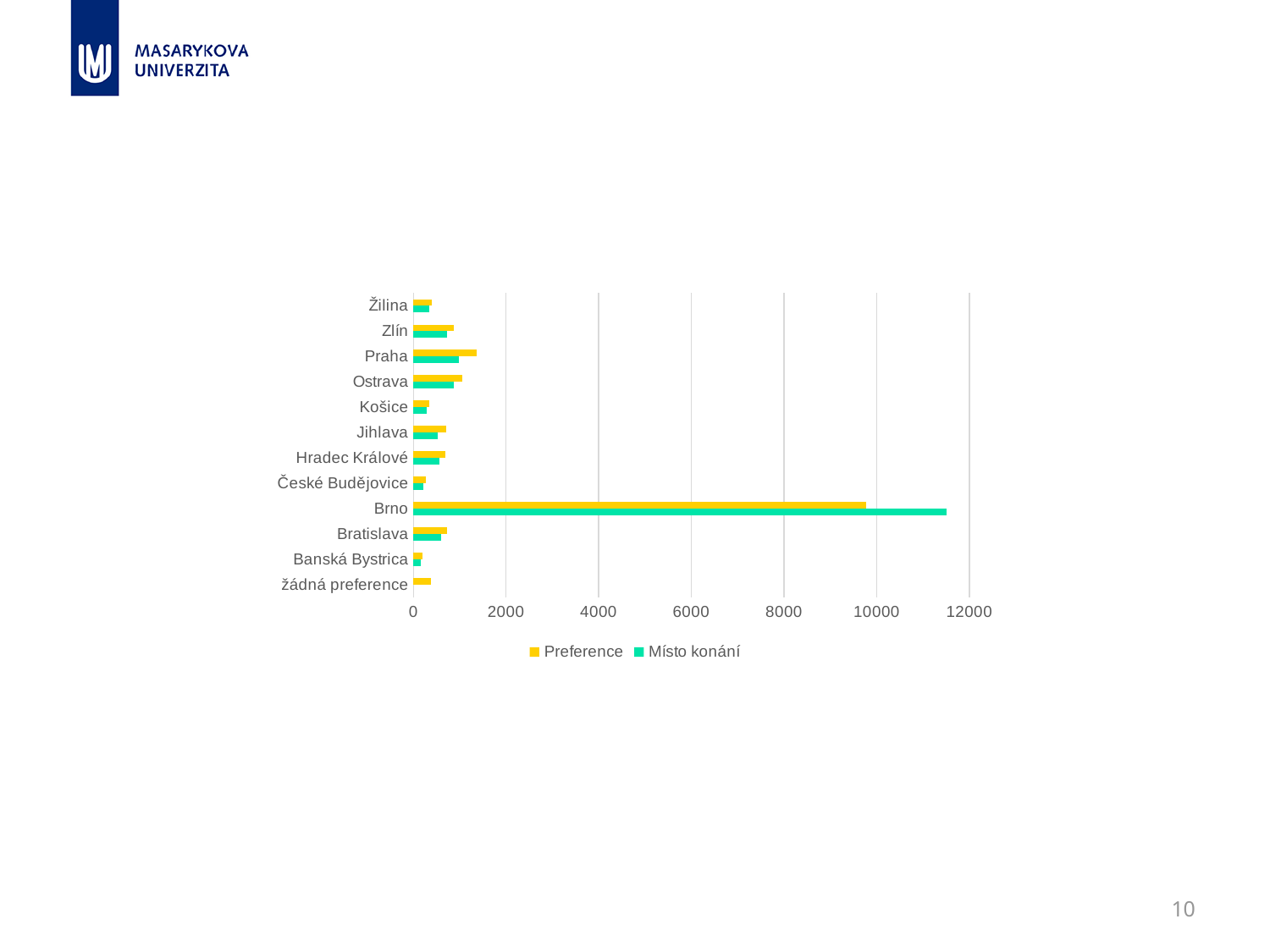
How many categories are shown on the vertical axis of the chart? 12 Which category has the highest Místo konání value? Brno Which series is shown in yellow in the legend? Preference Is the Preference value for Brno greater or less than 8000? greater What kind of chart is shown on the slide? bar chart How many series does the legend list? 2 Which series is shown in green in the legend? Místo konání Which category has the highest Preference value? Brno Is the Preference value for Praha greater or less than 2000? less For Brno, which series has the larger value, Preference or Místo konání? Místo konání Which has the larger Preference value, Praha or Zlín? Praha Is the Místo konání value for Brno greater or less than 10000? greater